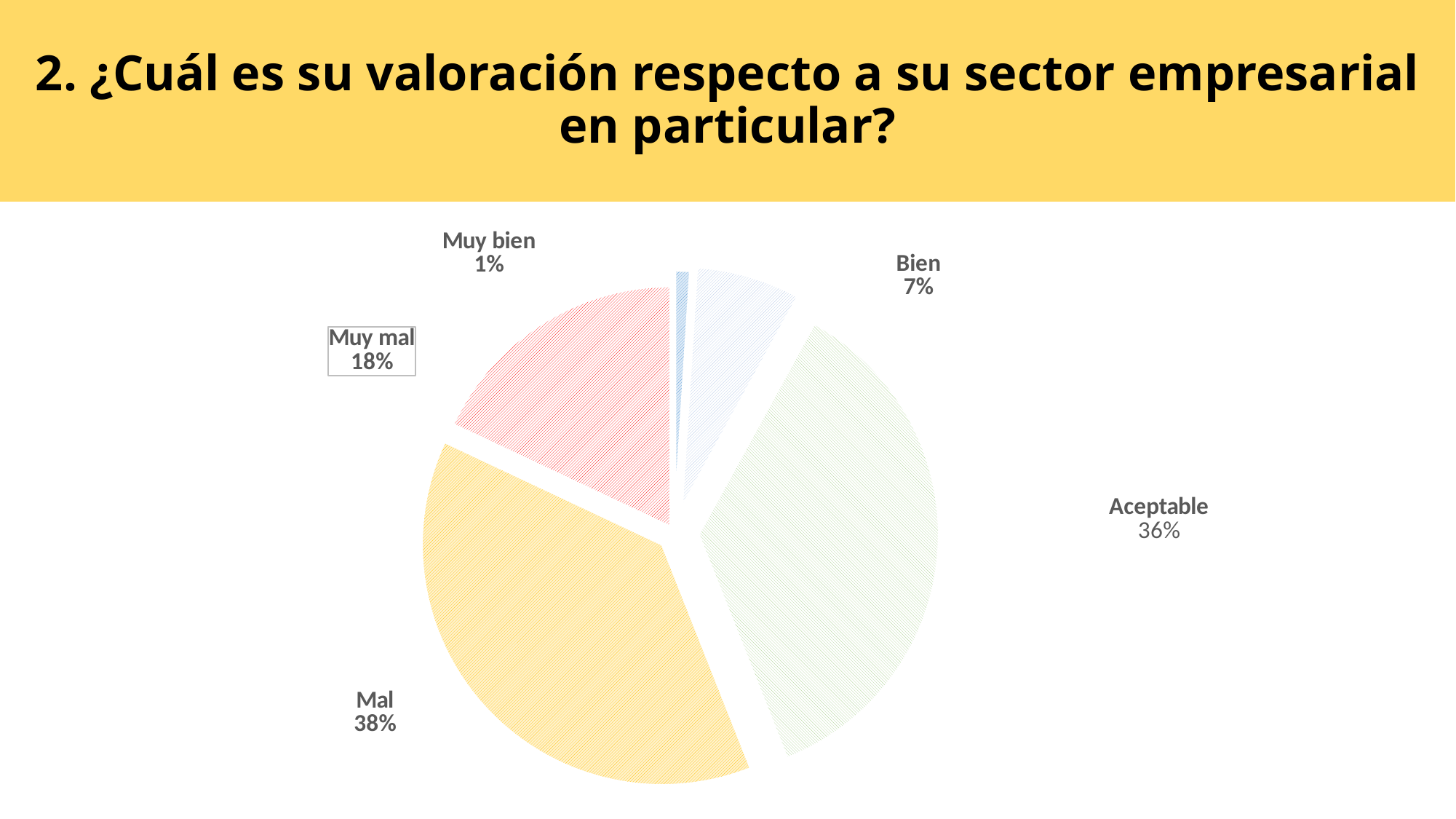
What percentage of respondents answered "Mal"? 38% What percentage of respondents answered "Bien"? 7% Which category has the largest share of the pie? Mal Which is larger, the share for "Bien" or the share for "Muy mal"? Muy mal What kind of chart is shown on the slide? pie chart Which category has the smallest share of the pie? Muy bien How many categories are shown in the pie chart? 5 What is the difference in percentage points between "Mal" and "Muy mal"? 20 What percentage of respondents answered "Aceptable"? 36% What percentage of respondents answered "Muy bien"? 1% What percentage of respondents answered "Muy mal"? 18% What is the title of the slide containing the chart? 2. ¿Cuál es su valoración respecto a su sector empresarial en particular?